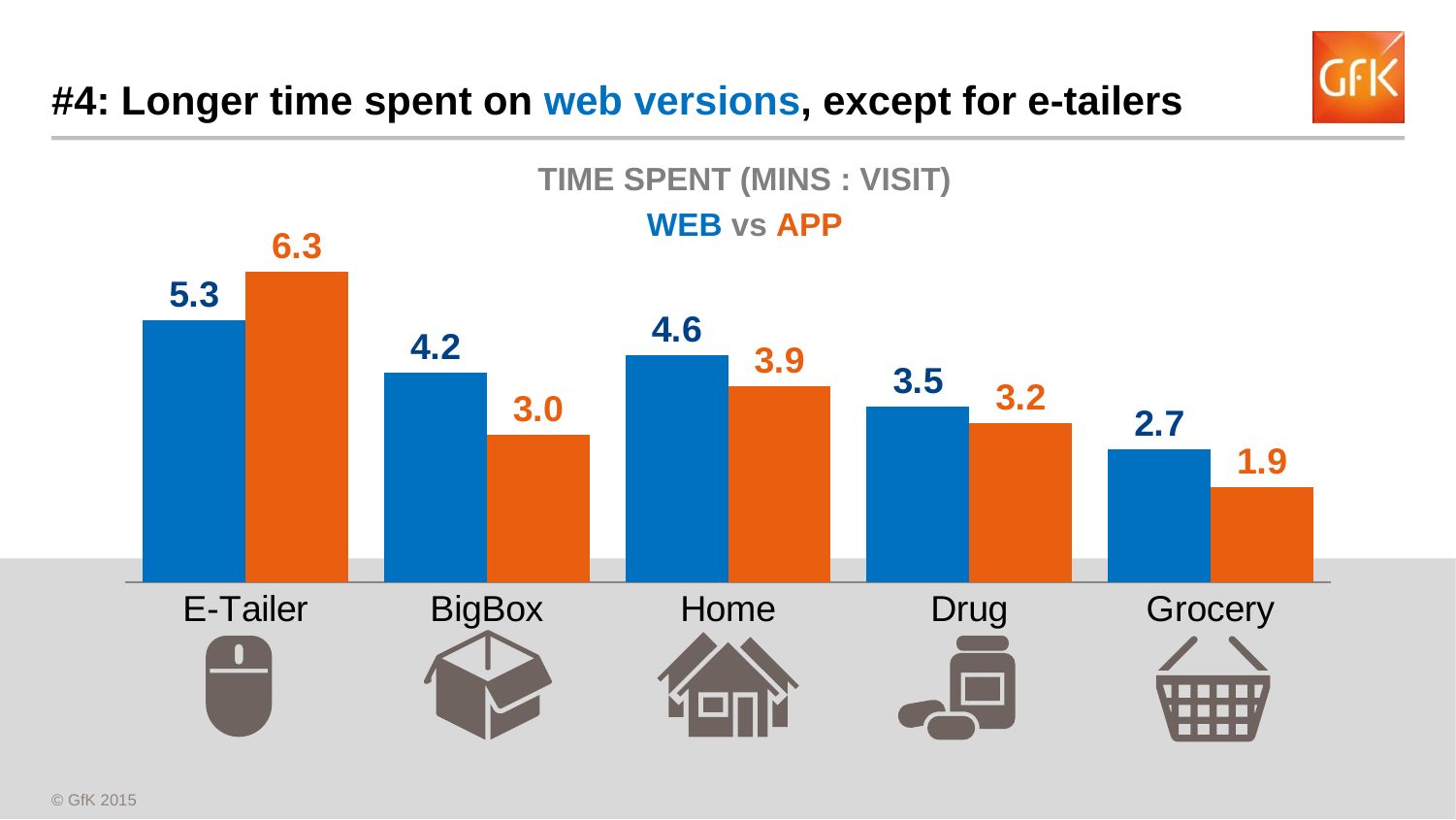
What is the WEB time spent value for E-Tailer? 5.3 What is the difference between the WEB and APP values for Home? 0.7 Which colour represents the APP series? Orange How many categories are shown on the x axis? 5 What kind of chart is shown on the slide? Bar chart Which category has the lowest WEB value? Grocery Which category has the highest APP value? E-Tailer Which is larger for Drug, the WEB value or the APP value? WEB Do the WEB values rise or fall from E-Tailer to Grocery? Fall How many series does the chart show? 2 What is the APP time spent value for Grocery? 1.9 What is the APP value for BigBox? 3.0